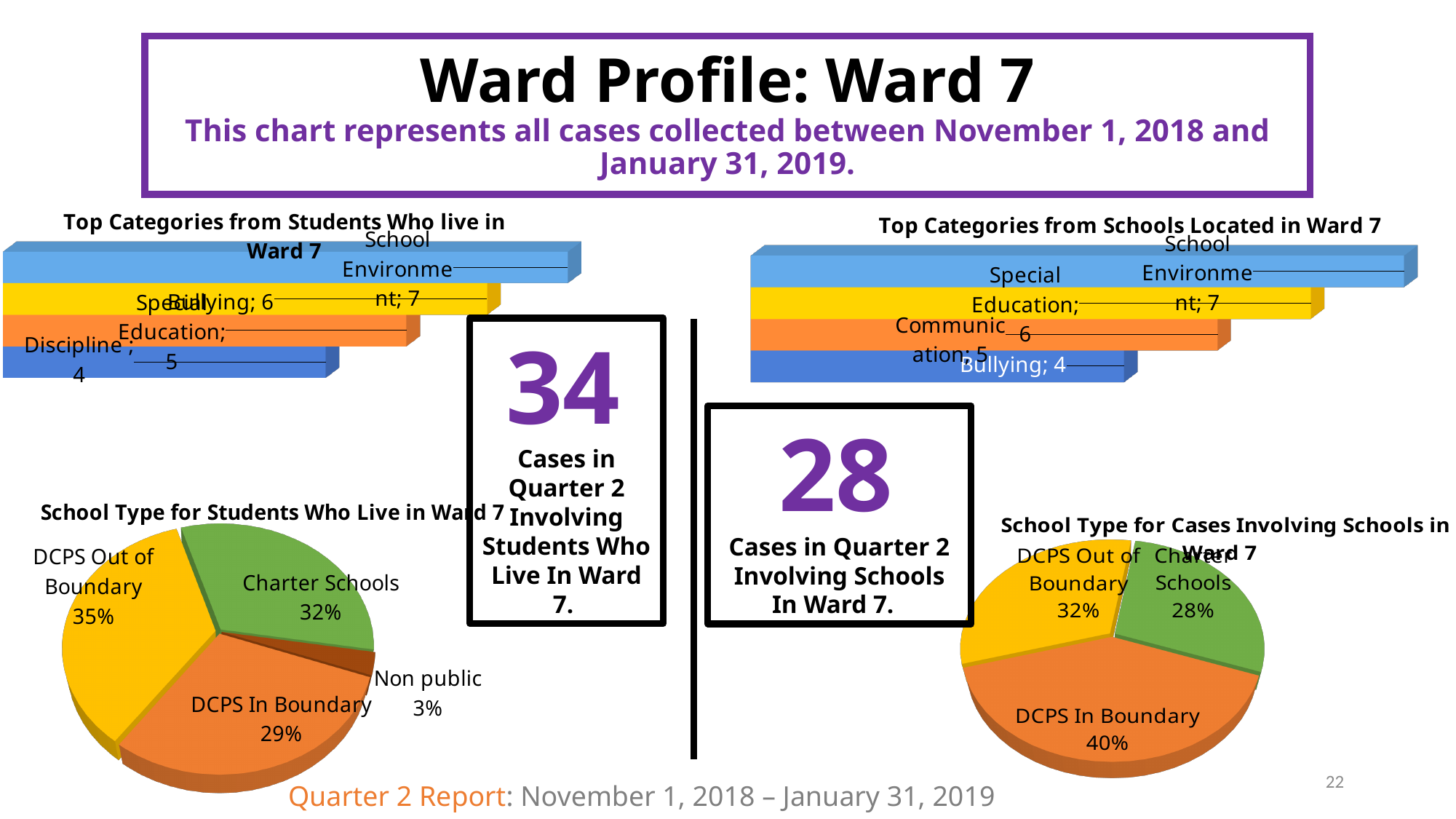
In the 'Top Categories from Students Who live in Ward 7' chart, which category has the lowest value? Discipline In the 'School Type for Students Who Live in Ward 7' pie chart, which school type has the smallest share? Non public In the 'Top Categories from Students Who live in Ward 7' chart, what is the value for School Environment? 7 In the 'School Type for Students Who Live in Ward 7' pie chart, what share is DCPS Out of Boundary? 35% In the 'Top Categories from Schools Located in Ward 7' chart, which is larger, Communication or Bullying? Communication In the 'Top Categories from Schools Located in Ward 7' chart, which category has the highest value? School Environment What kind of chart is 'Top Categories from Students Who live in Ward 7'? Bar chart In the 'Top Categories from Schools Located in Ward 7' chart, what is the value for Special Education? 6 In the 'Top Categories from Students Who live in Ward 7' chart, what is the difference between Bullying and Discipline? 2 In the 'School Type for Cases Involving Schools in Ward 7' pie chart, what share is DCPS In Boundary? 40% How many categories are shown in the 'Top Categories from Schools Located in Ward 7' chart? 4 How many slices are in the 'School Type for Cases Involving Schools in Ward 7' pie chart? 3